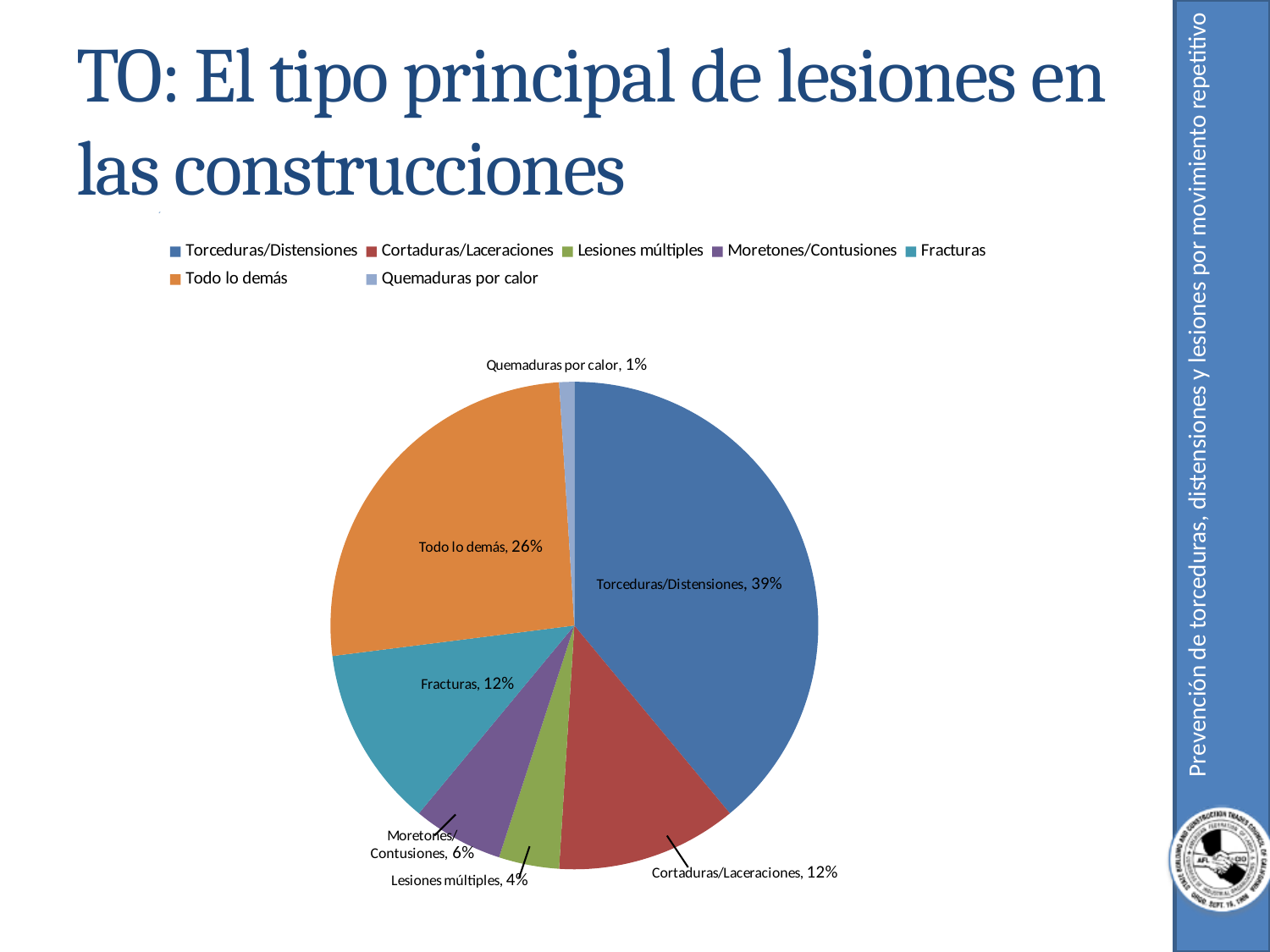
How many categories are shown in the pie chart? 7 What percentage of injuries is attributed to Torceduras/Distensiones? 39% Which category has the largest slice of the pie? Torceduras/Distensiones How many entries does the legend list? 7 What percentage is shown for Fracturas? 12% Which category has the smallest slice of the pie? Quemaduras por calor Which is larger, Moretones/Contusiones or Lesiones múltiples? Moretones/Contusiones What colour is the slice for Todo lo demás? Orange What is the value shown for Todo lo demás? 26% What is the difference in percentage points between Torceduras/Distensiones and Todo lo demás? 13 What kind of chart is shown on the slide? Pie chart What is the value for Quemaduras por calor? 1%